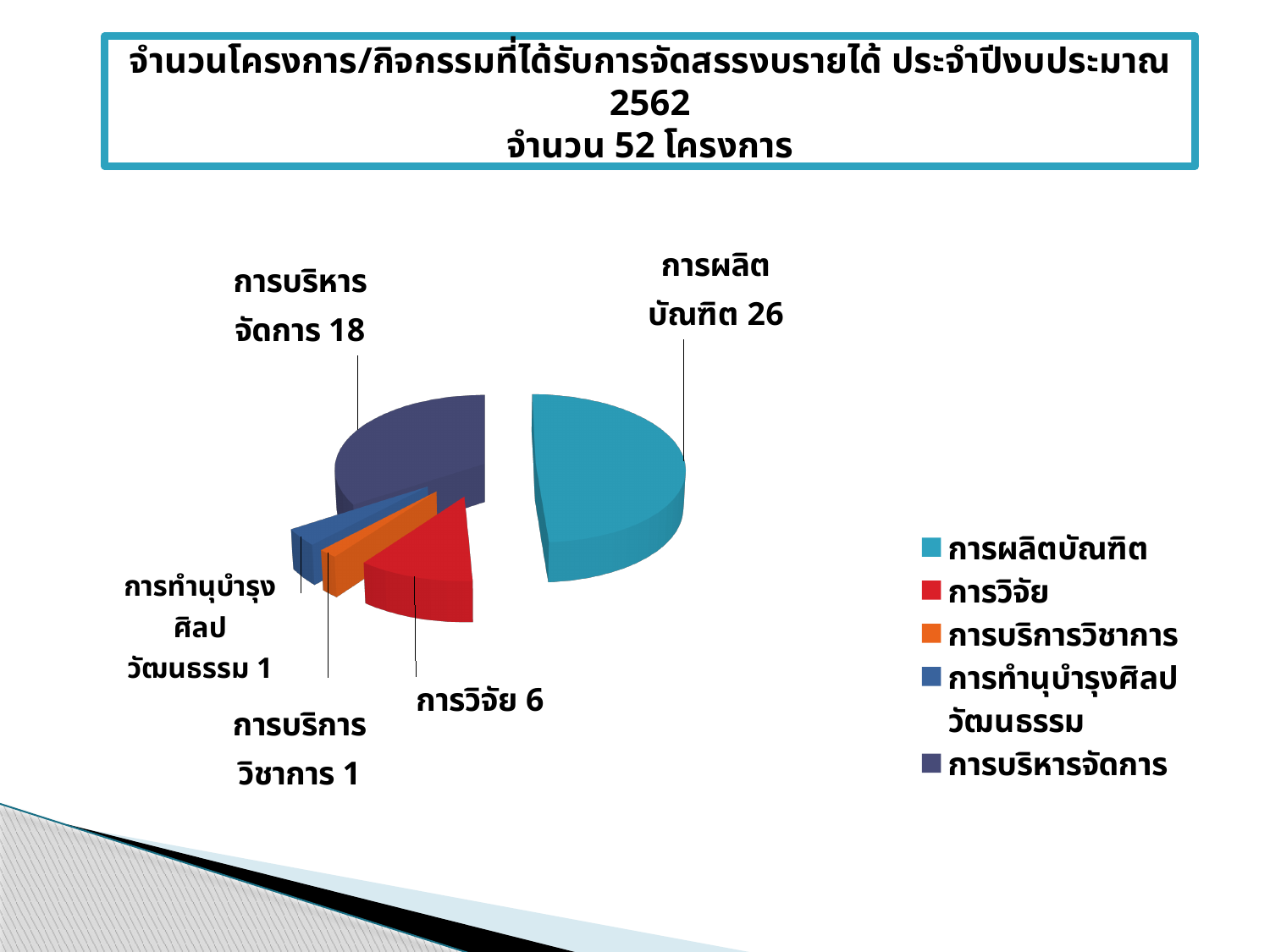
What colour is the slice for การวิจัย? Red Which category has the highest value? การผลิตบัณฑิต What share of the total does การผลิตบัณฑิต represent? 50% What is the value for การผลิตบัณฑิต? 26 What is the value for การบริหารจัดการ? 18 How many categories does the pie chart have? 5 What kind of chart is shown on the slide? Pie chart Which is larger, การวิจัย or การบริหารจัดการ? การบริหารจัดการ What is the difference between การผลิตบัณฑิต and การบริหารจัดการ? 8 What is the value for การบริการวิชาการ? 1 How many categories have a value of 1? 2 What is the value for การวิจัย? 6